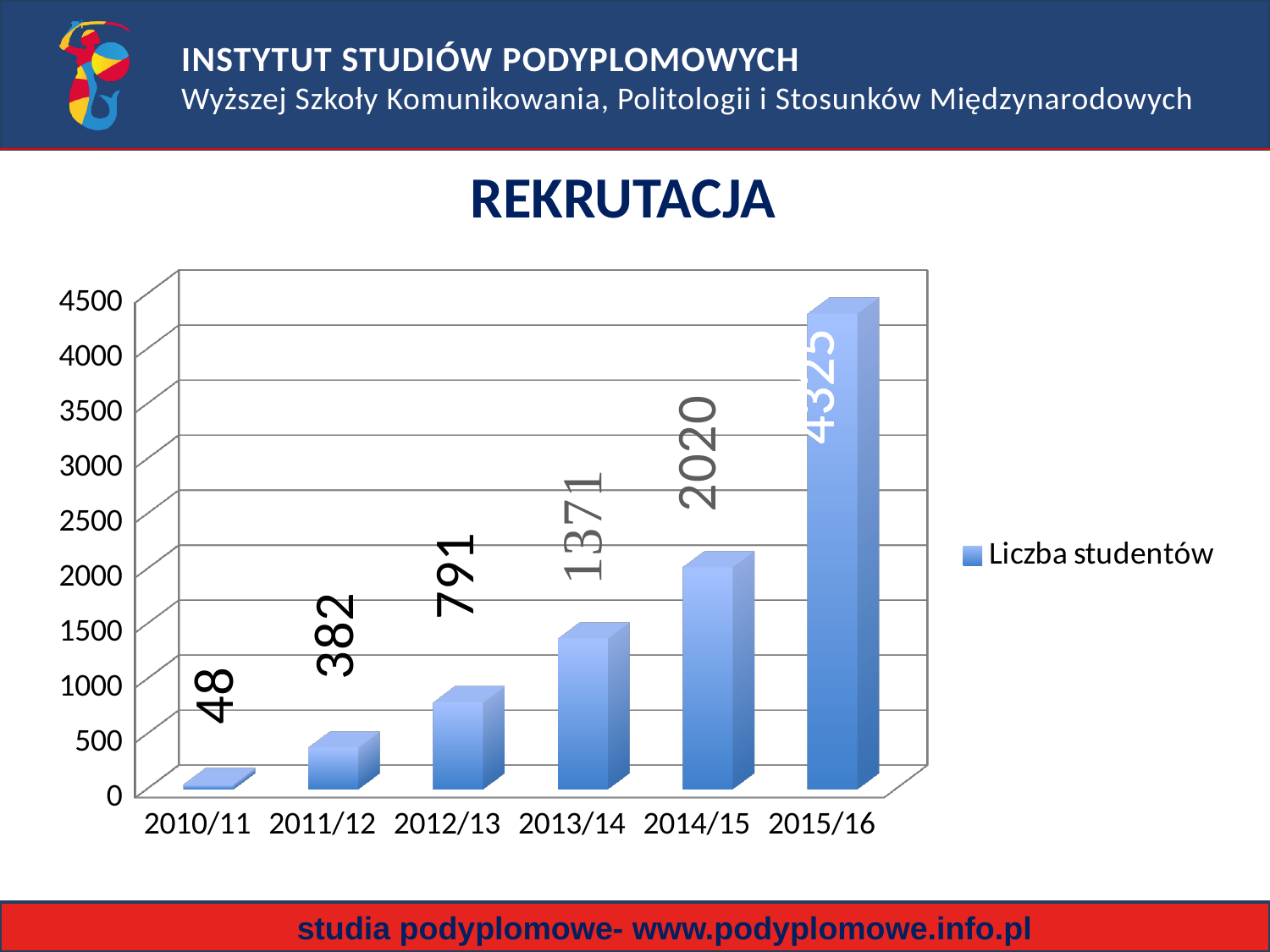
Which year has the lowest number of students? 2010/11 What is the difference between the values for 2015/16 and 2014/15? 2305 Is the value for 2014/15 greater or less than 2500? less What is the difference between the values for 2012/13 and 2011/12? 409 What kind of chart is shown? bar chart Do the values rise or fall from 2010/11 to 2015/16? rise Which year has the highest number of students? 2015/16 Which is larger, the value for 2013/14 or the value for 2014/15? 2014/15 How many years are shown on the x axis? 6 What is the value for 2015/16? 4325 What is the value for 2013/14? 1371 What is the value for 2010/11? 48